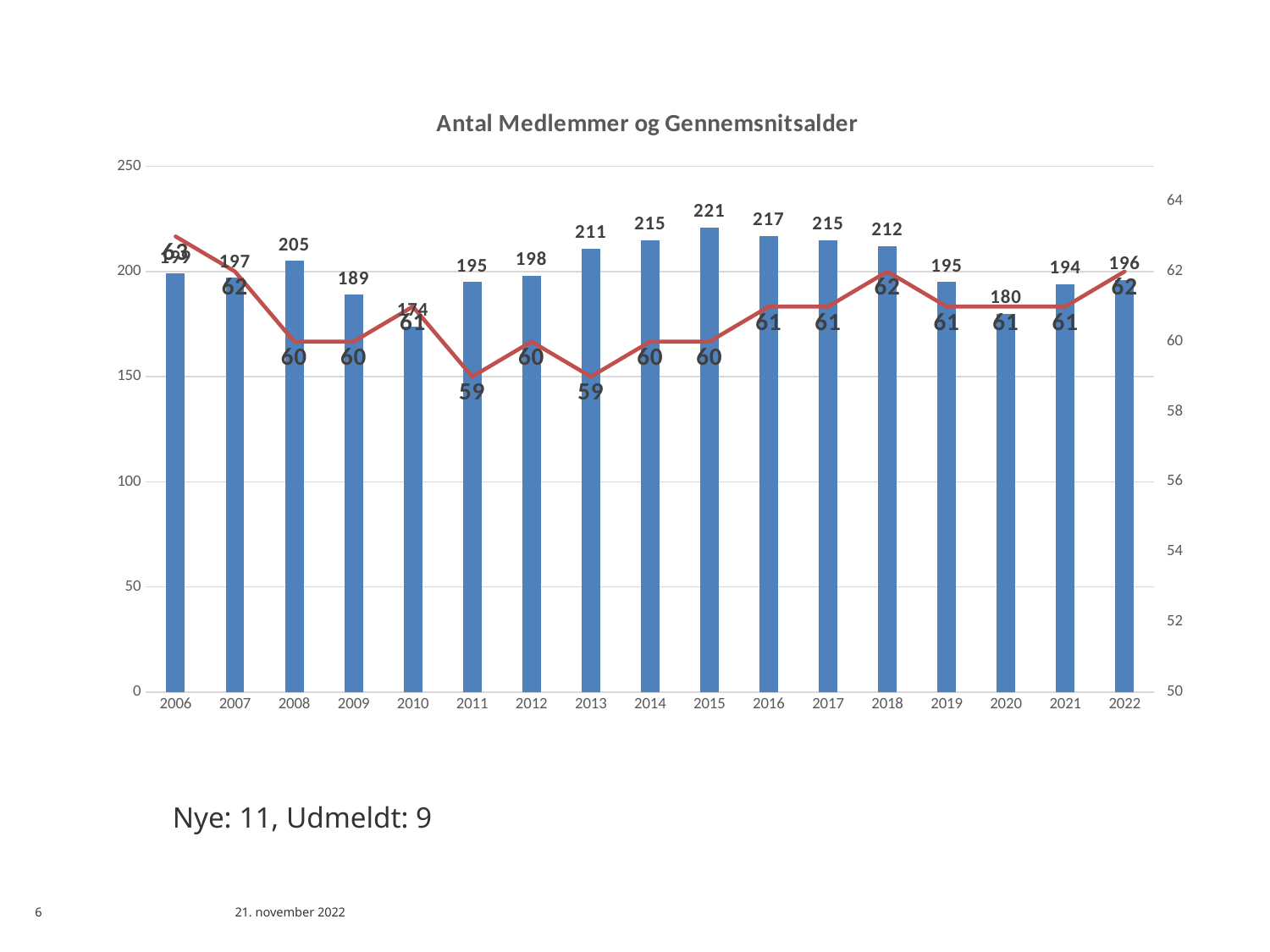
What kind of chart is this? Bar chart with a line Is the number of members for 2009 greater or less than 150? greater Which year has more members, 2013 or 2019? 2013 What is the title of the chart? Antal Medlemmer og Gennemsnitsalder What is the number of members (bar value) for 2022? 196 What is the average age (line value) for 2011? 59 What is the average age (line value) for 2018? 62 What is the number of members (bar value) for 2015? 221 Which year has the highest number of members? 2015 What is the difference in number of members between 2015 and 2020? 41 How many years are shown on the x axis? 17 Do the member numbers rise or fall from 2011 to 2015? rise